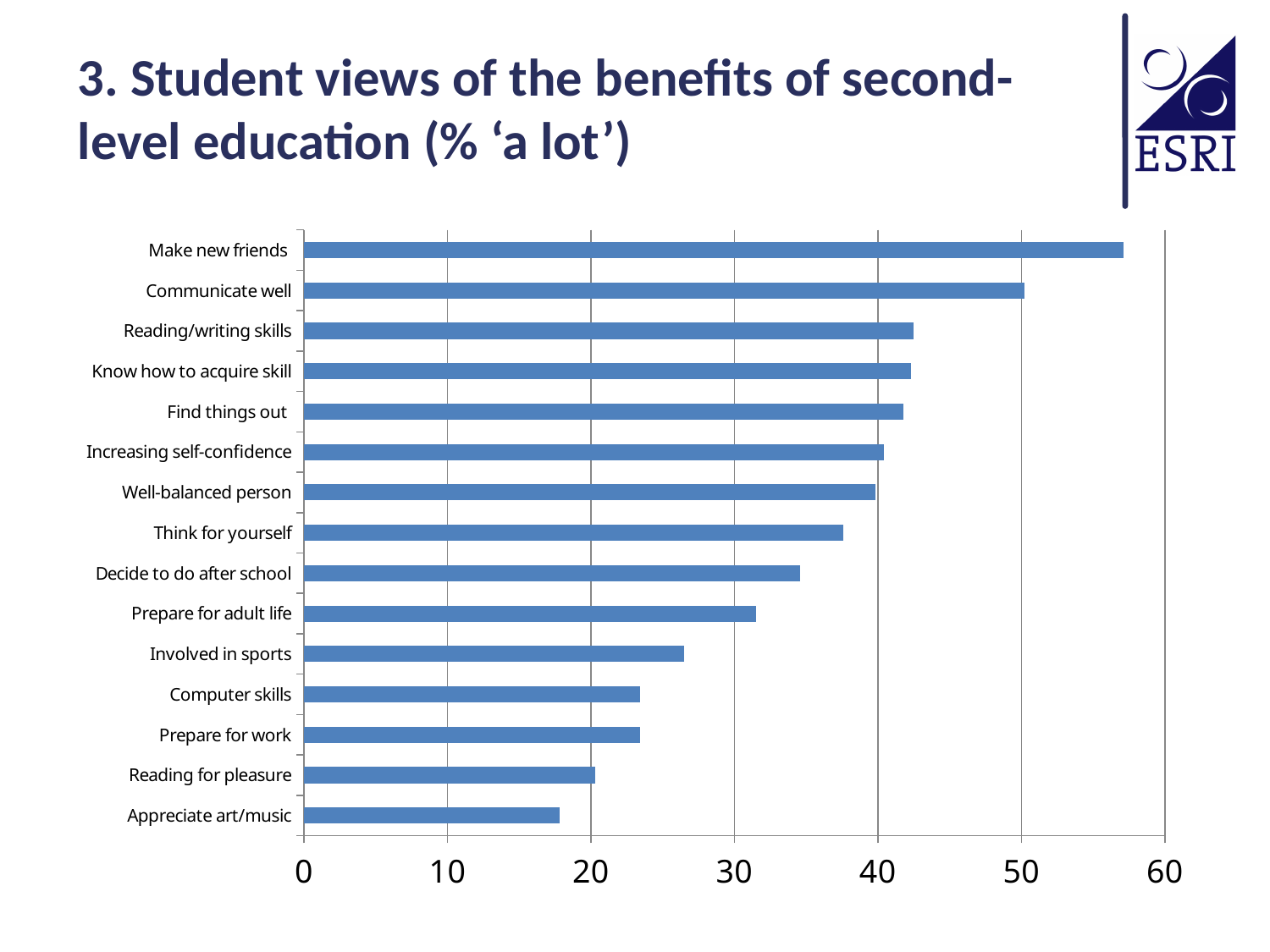
Is the value for Think for yourself greater or less than 40? less Is the value for Computer skills greater or less than 20? greater How many categories are plotted in the chart? 15 Is the value for Involved in sports greater or less than 30? less Which is larger, the value for Involved in sports or the value for Reading for pleasure? Involved in sports Which category has the lowest value? Appreciate art/music Which is larger, the value for Make new friends or the value for Communicate well? Make new friends What kind of chart is shown on the slide? bar chart Which category has the highest value? Make new friends